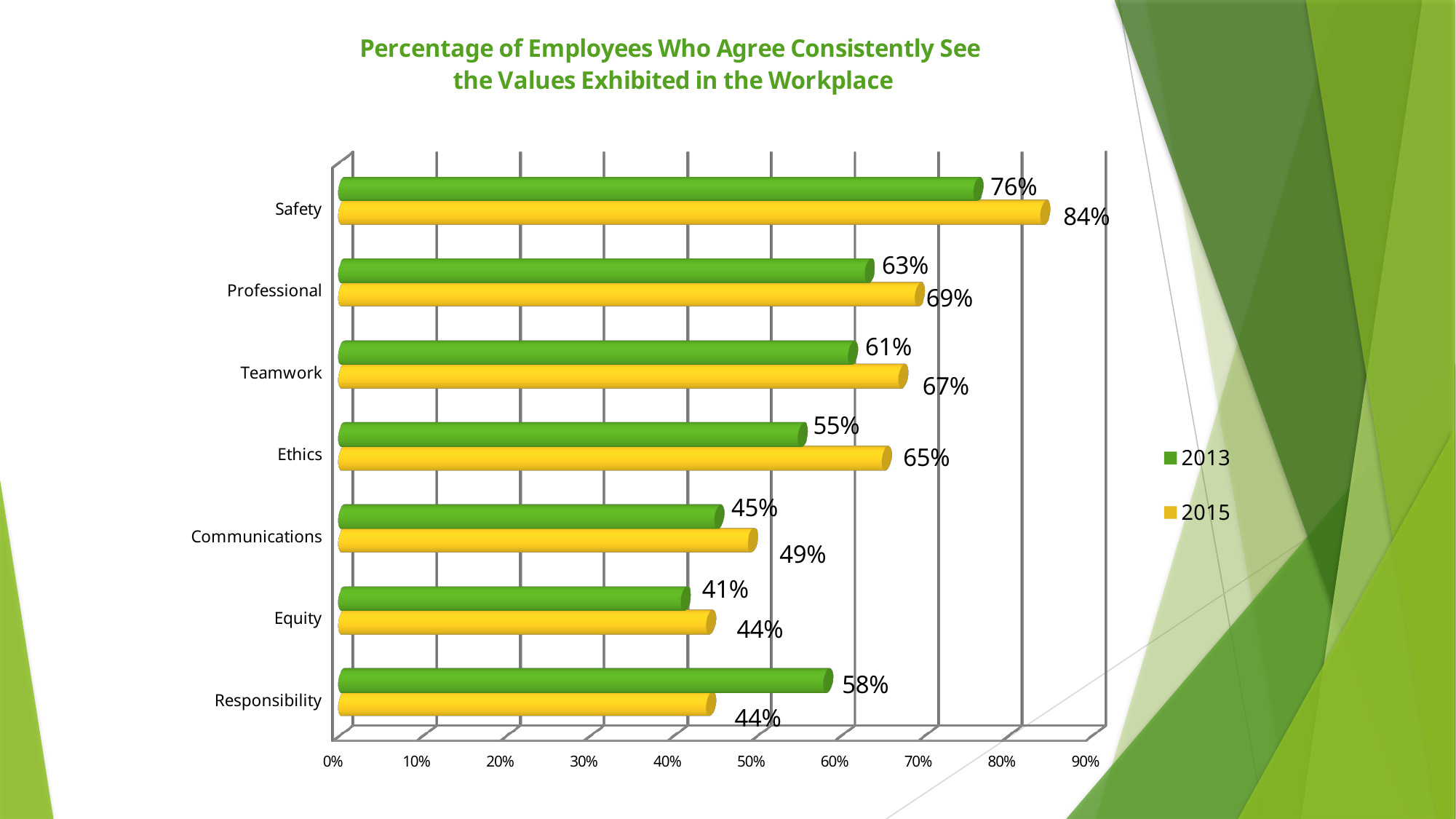
What is the 2013 value for Ethics? 55% Which is larger for Responsibility, the 2013 value or the 2015 value? 2013 What is the difference between the 2015 and 2013 values for Ethics? 10% How many categories are shown on the chart? 7 What is the 2013 value for Responsibility? 58% Which colour represents the 2015 series? Yellow What is the 2015 value for Safety? 84% Which category has the highest 2015 value? Safety What is the difference between the 2015 values for Safety and Professional? 15% How many series does the legend list? 2 Which category has the lowest 2013 value? Equity What kind of chart is shown on the slide? Bar chart